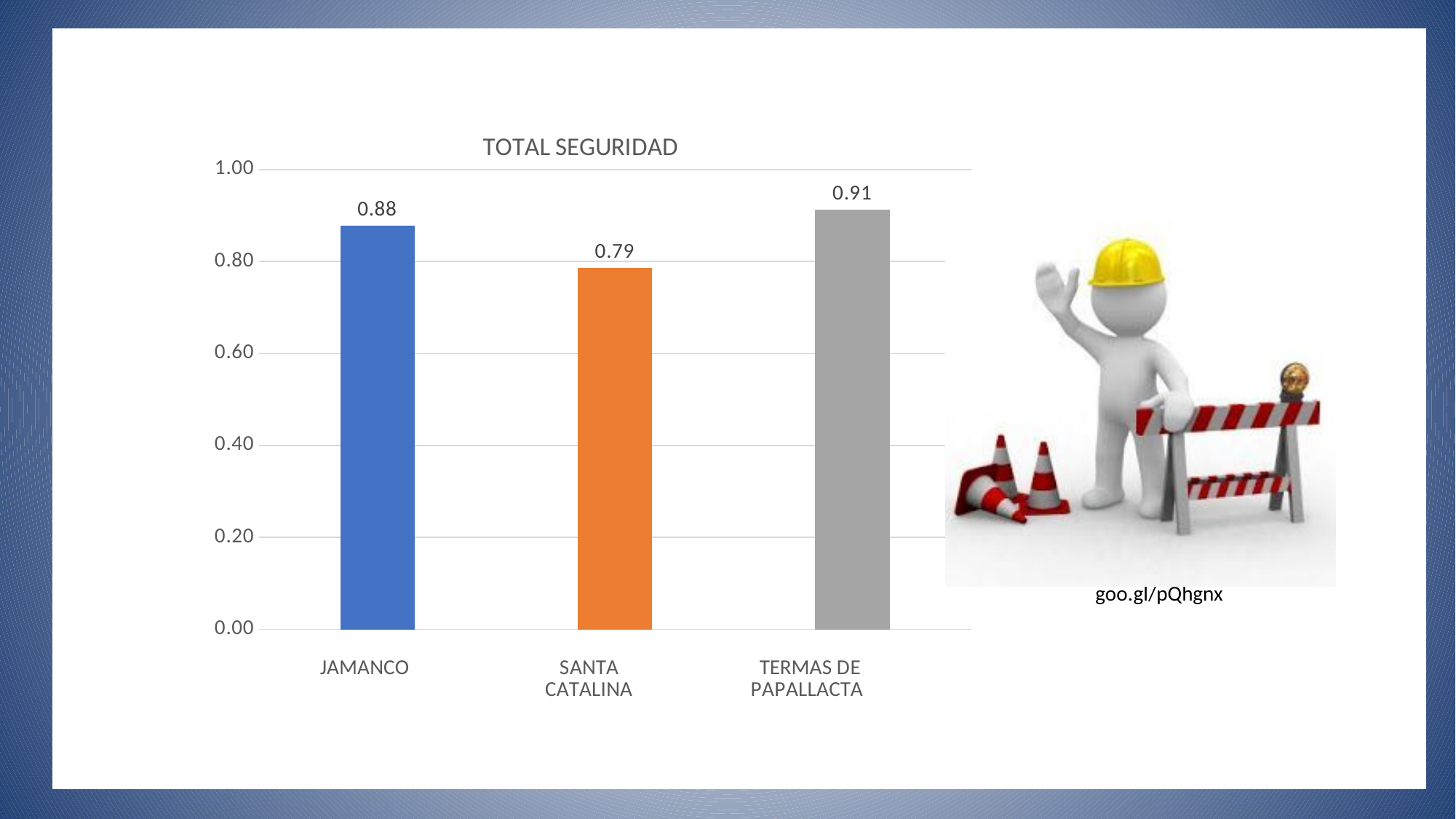
What is the value for TERMAS DE PAPALLACTA? 0.91 How many categories are shown in the chart? 3 Is the value for SANTA CATALINA greater or less than 0.80? less What is the value for SANTA CATALINA? 0.79 What kind of chart is shown on the slide? bar chart Which category has the lowest value? SANTA CATALINA What is the difference between the values for TERMAS DE PAPALLACTA and SANTA CATALINA? 0.12 Which is larger, the value for JAMANCO or the value for TERMAS DE PAPALLACTA? TERMAS DE PAPALLACTA What is the title of the chart? TOTAL SEGURIDAD What is the value for JAMANCO? 0.88 Which category has the highest value? TERMAS DE PAPALLACTA What is the difference between the values for JAMANCO and SANTA CATALINA? 0.09